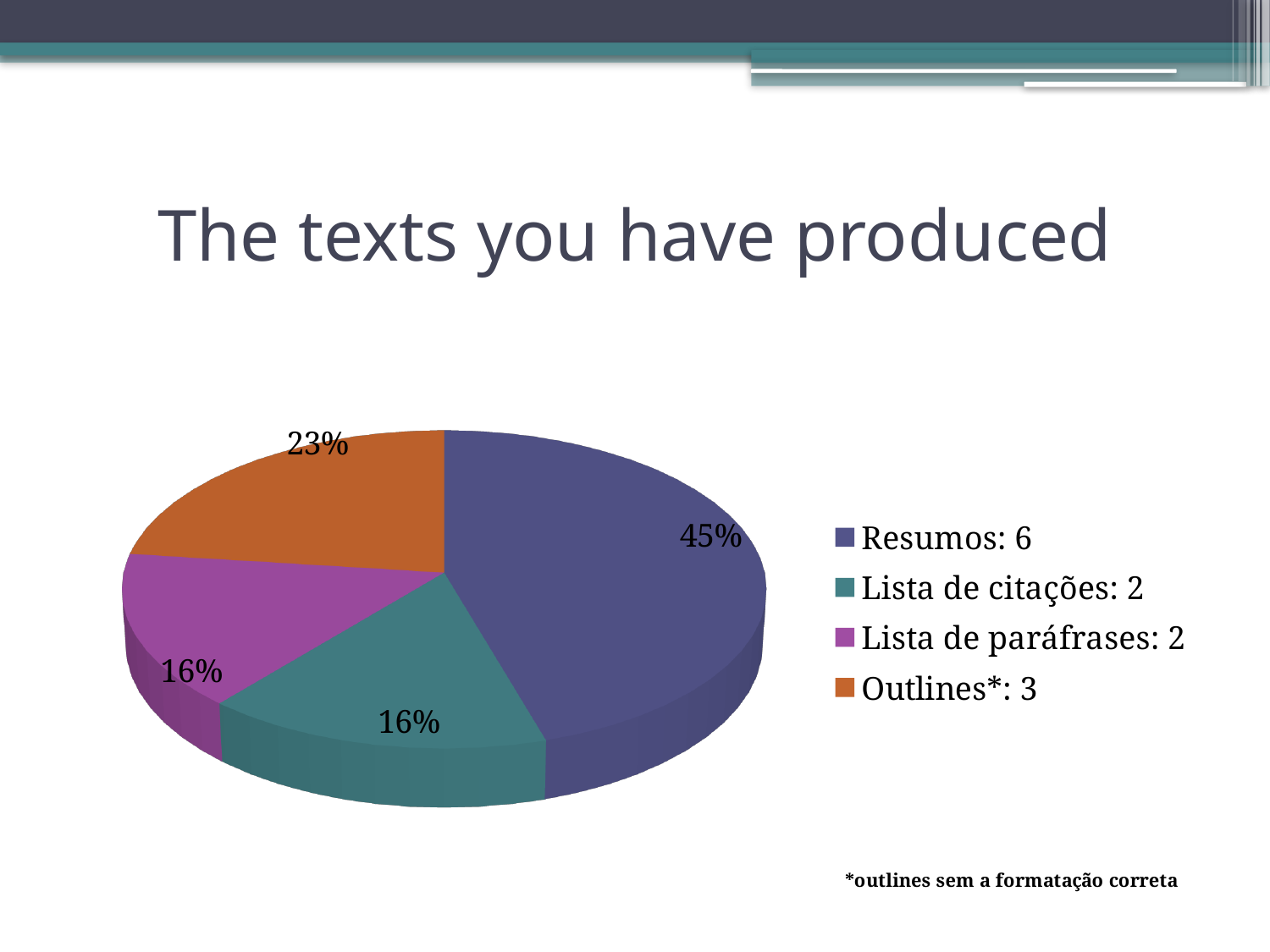
What is the title of the slide containing the pie chart? The texts you have produced How many slices does the pie chart have? 4 Which slice is larger, Outlines* or Lista de paráfrases? Outlines* What is the difference in percentage points between the Resumos slice and the Outlines* slice? 22 What percentage of the pie does the Resumos slice represent? 45% According to the legend, how many Outlines* were produced? 3 What percentage of the pie does the Outlines* slice represent? 23% According to the legend, how many Resumos were produced? 6 What kind of chart is shown on the slide? pie chart What percentage of the pie does the Lista de citações slice represent? 16% How many entries does the legend list? 4 Which category has the largest slice of the pie? Resumos